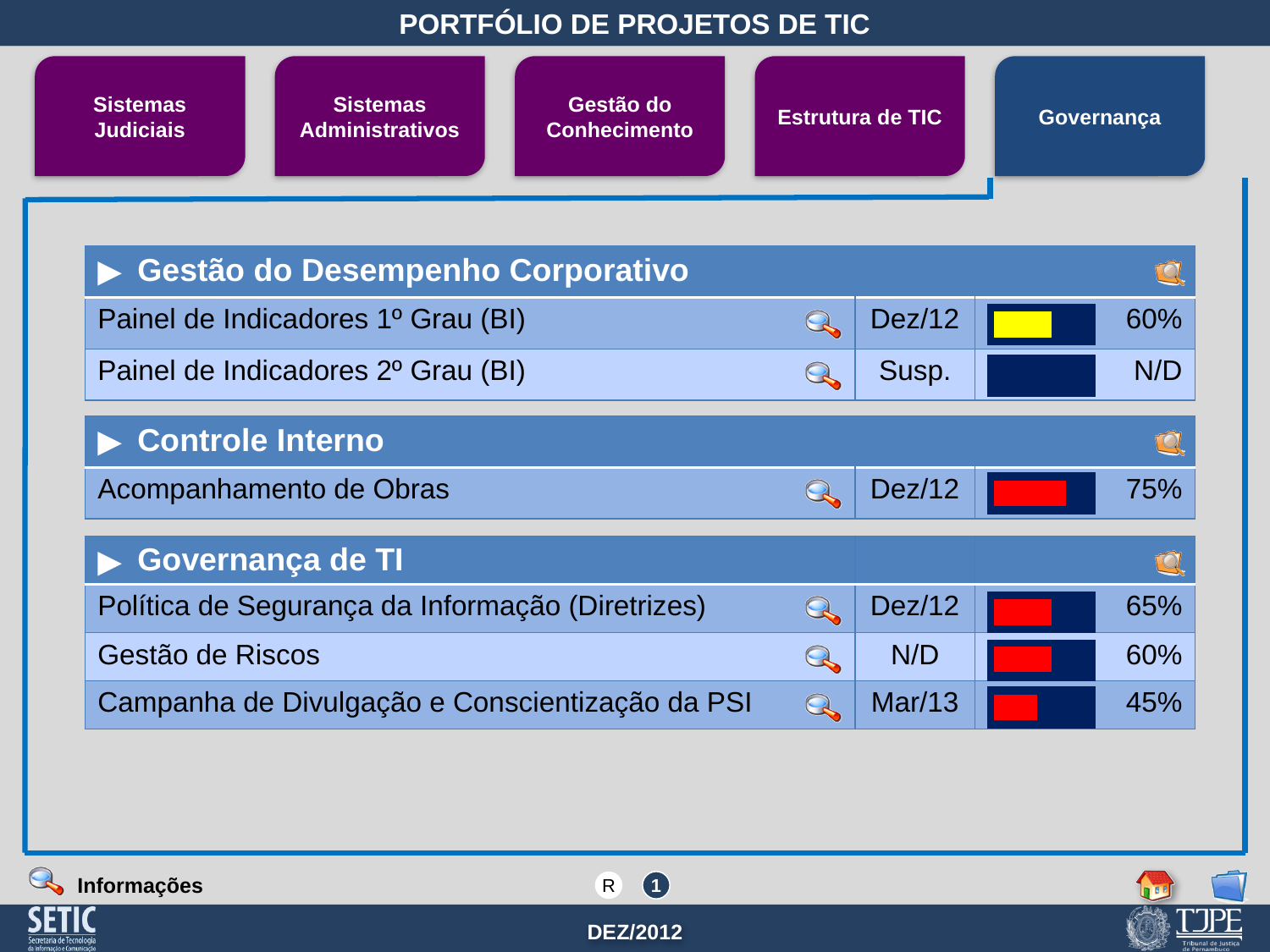
What deadline is shown for Campanha de Divulgação e Conscientização da PSI? Mar/13 What completion percentage is shown for Gestão de Riscos? 60% What colour is the progress bar for Painel de Indicadores 1º Grau (BI)? Yellow Which project has the lowest completion percentage among those with a percentage shown? Campanha de Divulgação e Conscientização da PSI Which project has the highest completion percentage on the slide? Acompanhamento de Obras How many projects are listed under Governança de TI? 3 What completion percentage is shown for Campanha de Divulgação e Conscientização da PSI? 45% What completion percentage is shown for Painel de Indicadores 1º Grau (BI)? 60% What completion percentage is shown for Política de Segurança da Informação (Diretrizes)? 65% Which has a higher completion percentage, Política de Segurança da Informação (Diretrizes) or Gestão de Riscos? Política de Segurança da Informação (Diretrizes) What completion percentage is shown for Acompanhamento de Obras? 75% What is the difference between the completion percentages of Acompanhamento de Obras and Campanha de Divulgação e Conscientização da PSI? 30%